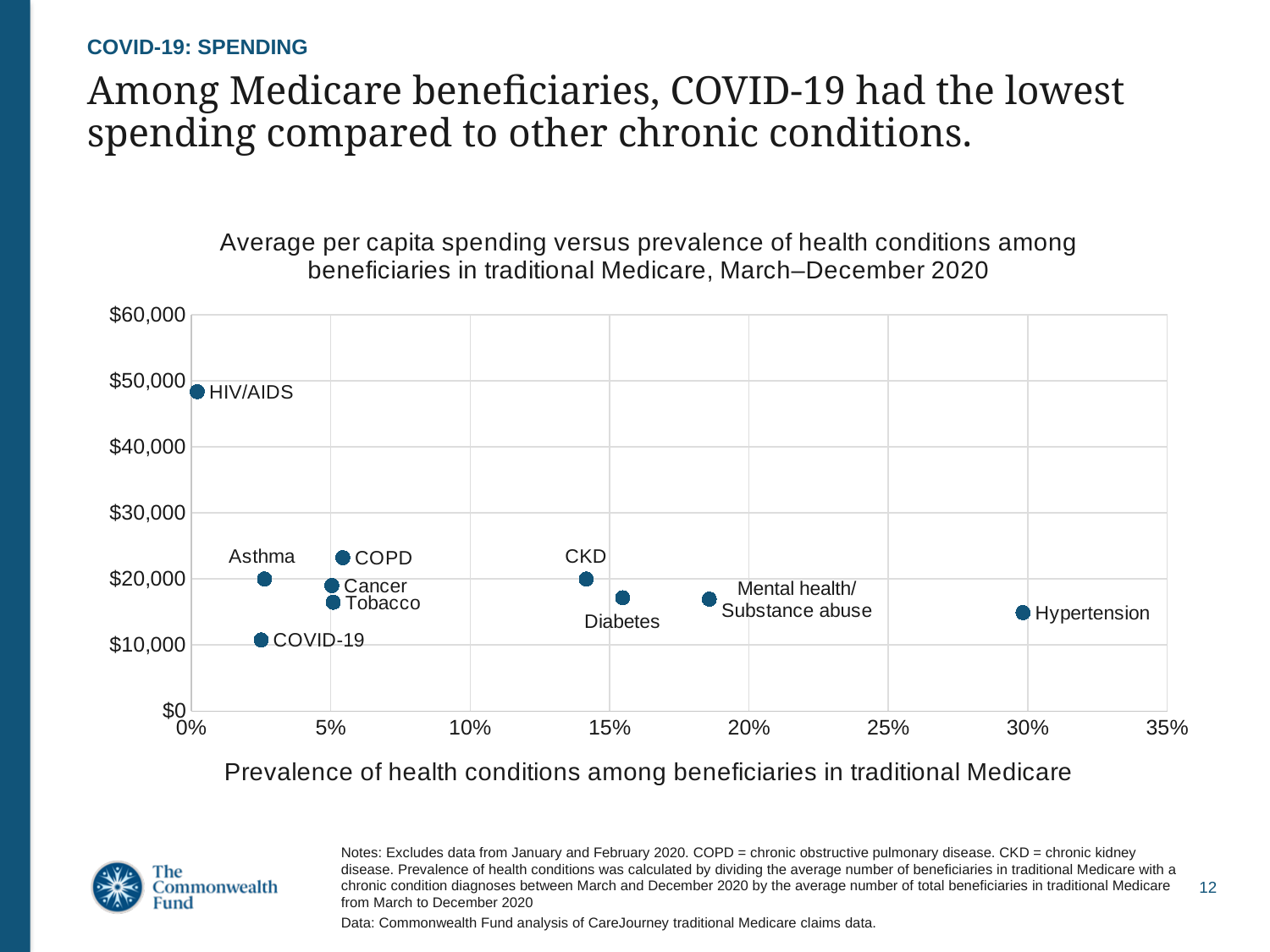
Which health condition has the highest average per capita spending? HIV/AIDS Which health condition has the highest prevalence among beneficiaries in traditional Medicare? Hypertension Which health condition has the lowest average per capita spending? COVID-19 Which has higher average per capita spending, COPD or Tobacco? COPD Is the average per capita spending for HIV/AIDS greater or less than $40,000? greater Which has higher prevalence, Hypertension or Diabetes? Hypertension What kind of chart is shown on the slide? Scatter chart Is the prevalence of Hypertension greater or less than 25%? greater What is the label of the horizontal axis of the chart? Prevalence of health conditions among beneficiaries in traditional Medicare Is the average per capita spending for COVID-19 greater or less than $20,000? less Which health condition has the lowest prevalence among beneficiaries in traditional Medicare? HIV/AIDS How many health conditions are plotted on the chart? 10